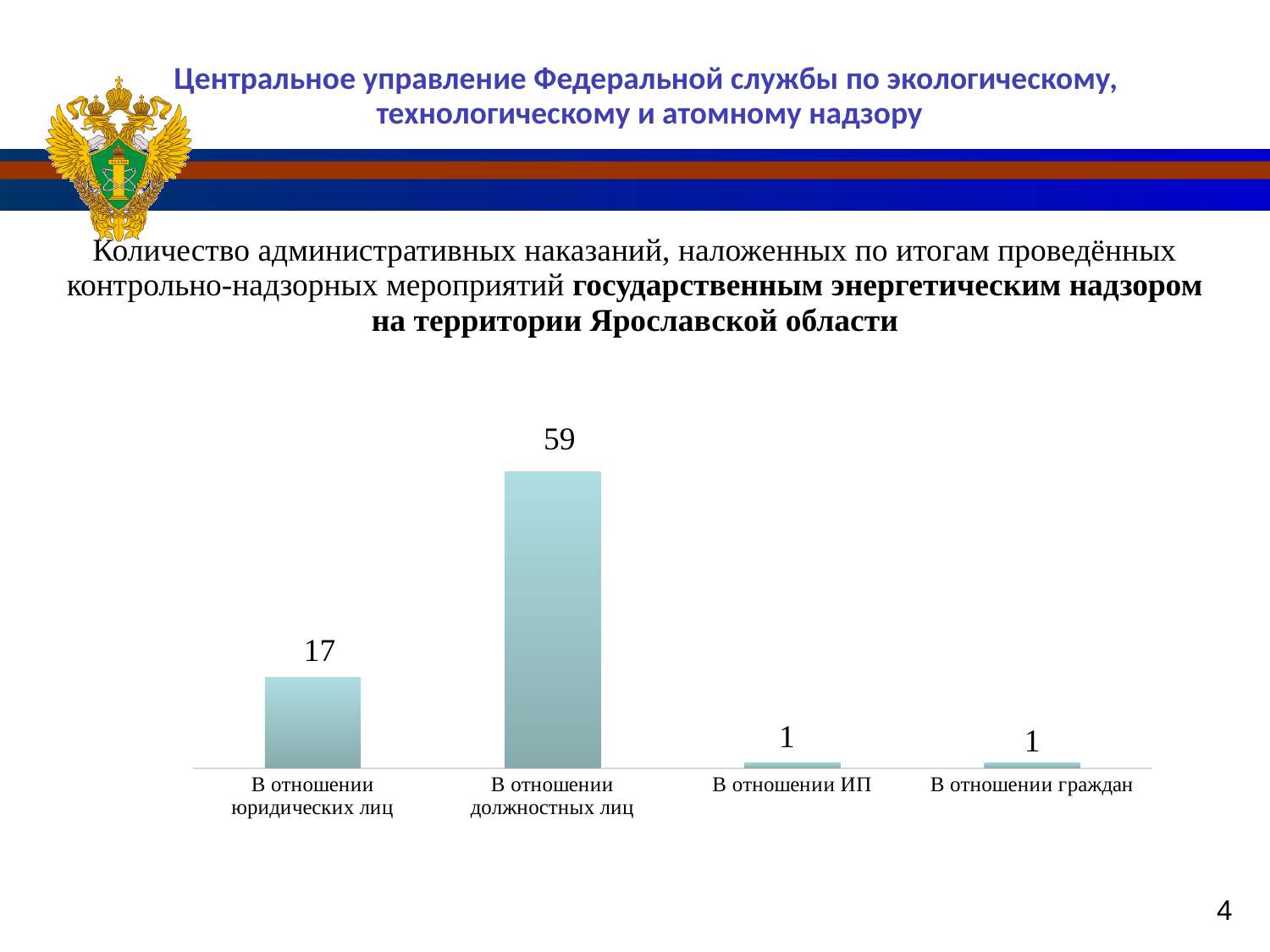
What is the value for «В отношении ИП»? 1 Which is larger: the value for «В отношении юридических лиц» or the value for «В отношении ИП»? В отношении юридических лиц What is the value for «В отношении юридических лиц»? 17 What is the value for «В отношении должностных лиц»? 59 What is the total of all four values shown in the chart? 78 What is the difference between the values for «В отношении должностных лиц» and «В отношении юридических лиц»? 42 What is the difference between the values for «В отношении юридических лиц» and «В отношении граждан»? 16 How many categories are shown in the chart? 4 What is the value for «В отношении граждан»? 1 Which category has the highest value? В отношении должностных лиц What kind of chart is shown on the slide? Bar chart Which two categories share the same value in the chart? В отношении ИП and В отношении граждан